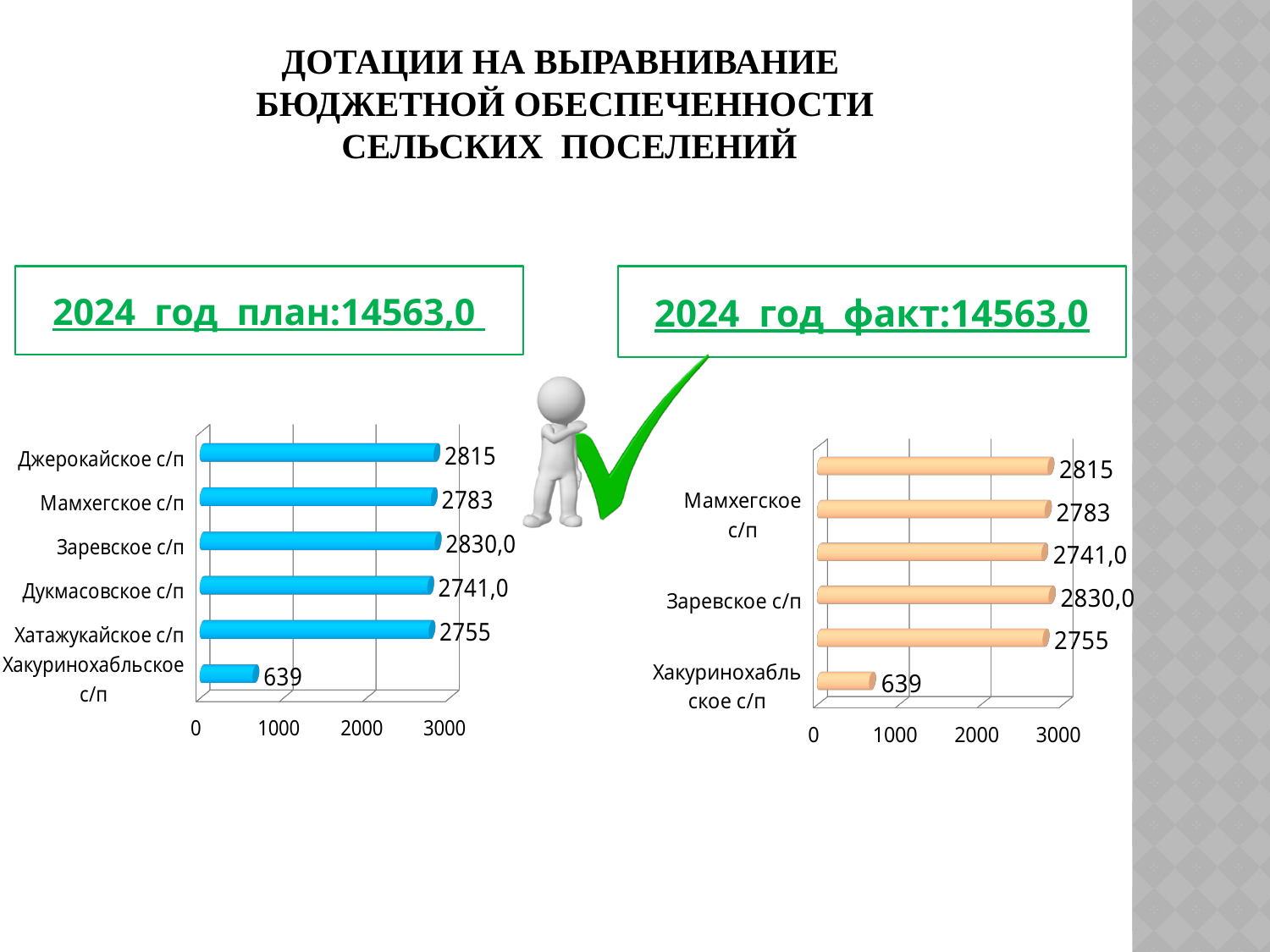
In the left chart (2024 год план), is the value for Хакуринохабльское с/п greater or less than 1000? less How many categories are shown in the left chart (2024 год план)? 6 In the left chart (2024 год план), which category has the highest value? Заревское с/п What type of chart is the right chart (2024 год факт)? bar chart In the left chart (2024 год план), what is the value for Заревское с/п? 2830,0 In the left chart (2024 год план), what is the value for Джерокайское с/п? 2815 What colour are the bars in the left chart (2024 год план)? blue In the left chart (2024 год план), what is the difference between the values for Хатажукайское с/п and Хакуринохабльское с/п? 2116 In the right chart (2024 год факт), what is the value for Хакуринохабльское с/п? 639 In the left chart (2024 год план), which is larger: the value for Мамхегское с/п or the value for Хатажукайское с/п? Мамхегское с/п In the left chart (2024 год план), which category has the lowest value? Хакуринохабльское с/п In the left chart (2024 год план), what is the value for Дукмасовское с/п? 2741,0